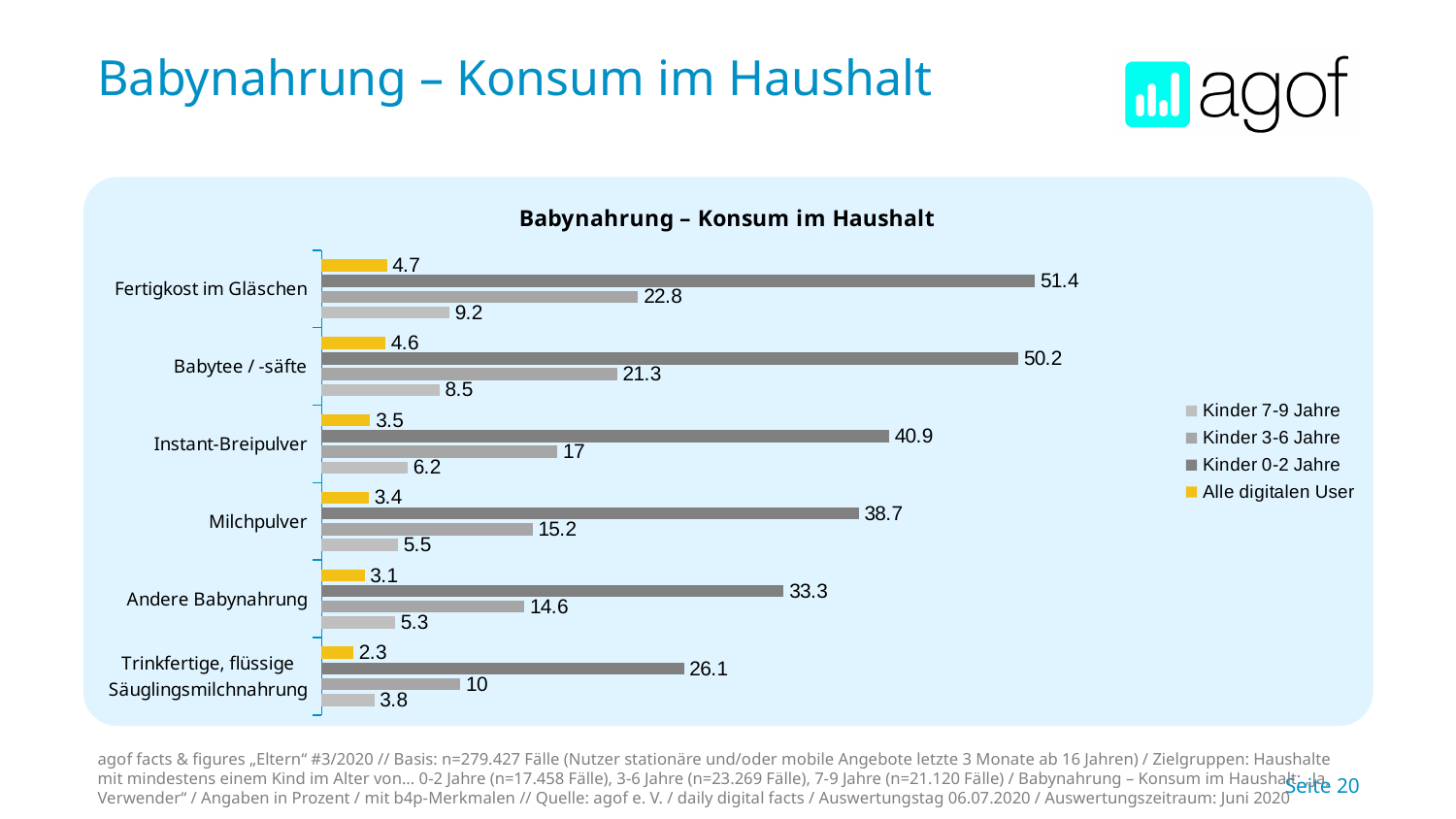
Which category has the highest value for Kinder 0-2 Jahre? Fertigkost im Gläschen Which category has the lowest value for Alle digitalen User? Trinkfertige, flüssige Säuglingsmilchnahrung Which is larger for Andere Babynahrung: the value for Kinder 3-6 Jahre or the value for Kinder 7-9 Jahre? Kinder 3-6 Jahre What kind of chart is shown on the slide? Bar chart What is the difference between the Kinder 0-2 Jahre value and the Kinder 3-6 Jahre value for Babytee / -säfte? 28.9 How many categories are shown on the chart? 6 What is the value for Kinder 3-6 Jahre for Instant-Breipulver? 17 What is the value for Kinder 0-2 Jahre for Fertigkost im Gläschen? 51.4 Which series is shown in yellow? Alle digitalen User What is the value for Alle digitalen User for Milchpulver? 3.4 How many series does the legend list? 4 What is the value for Kinder 7-9 Jahre for Trinkfertige, flüssige Säuglingsmilchnahrung? 3.8